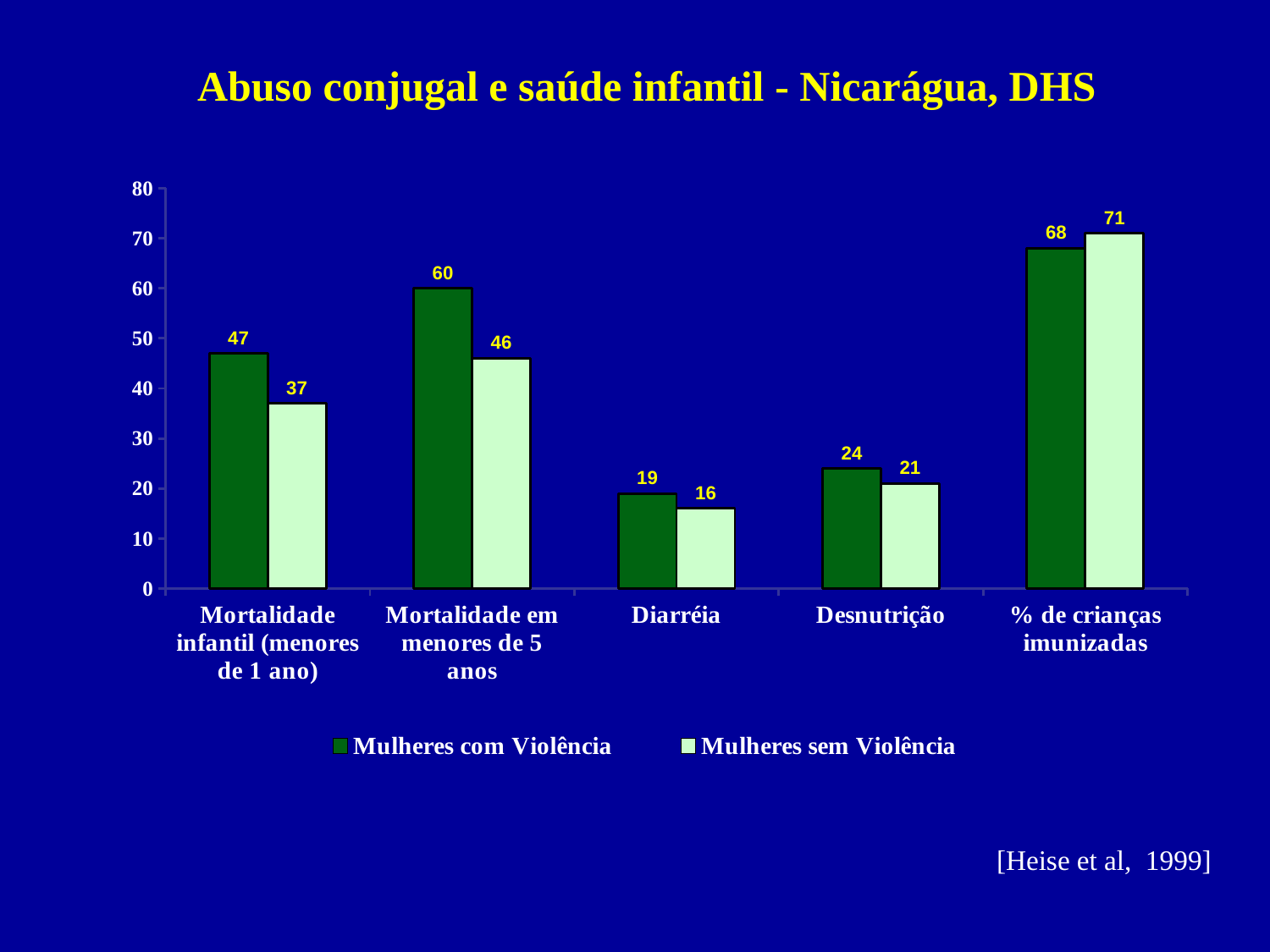
What is the value for "Mulheres com Violência" in the "Mortalidade infantil (menores de 1 ano)" category? 47 In the "Desnutrição" category, which series has the larger value? Mulheres com Violência What is the value for "Mulheres sem Violência" in the "Diarréia" category? 16 How many categories are shown on the x axis? 5 What is the value for "Mulheres sem Violência" in the "% de crianças imunizadas" category? 71 What is the title of the chart? Abuso conjugal e saúde infantil - Nicarágua, DHS What is the difference between the "Mulheres com Violência" and "Mulheres sem Violência" values in the "Mortalidade em menores de 5 anos" category? 14 How many series does the legend list? 2 Which category has the lowest value for "Mulheres sem Violência"? Diarréia In the "% de crianças imunizadas" category, which series has the larger value? Mulheres sem Violência Which category has the highest value for "Mulheres com Violência"? % de crianças imunizadas What kind of chart is shown on the slide? Bar chart